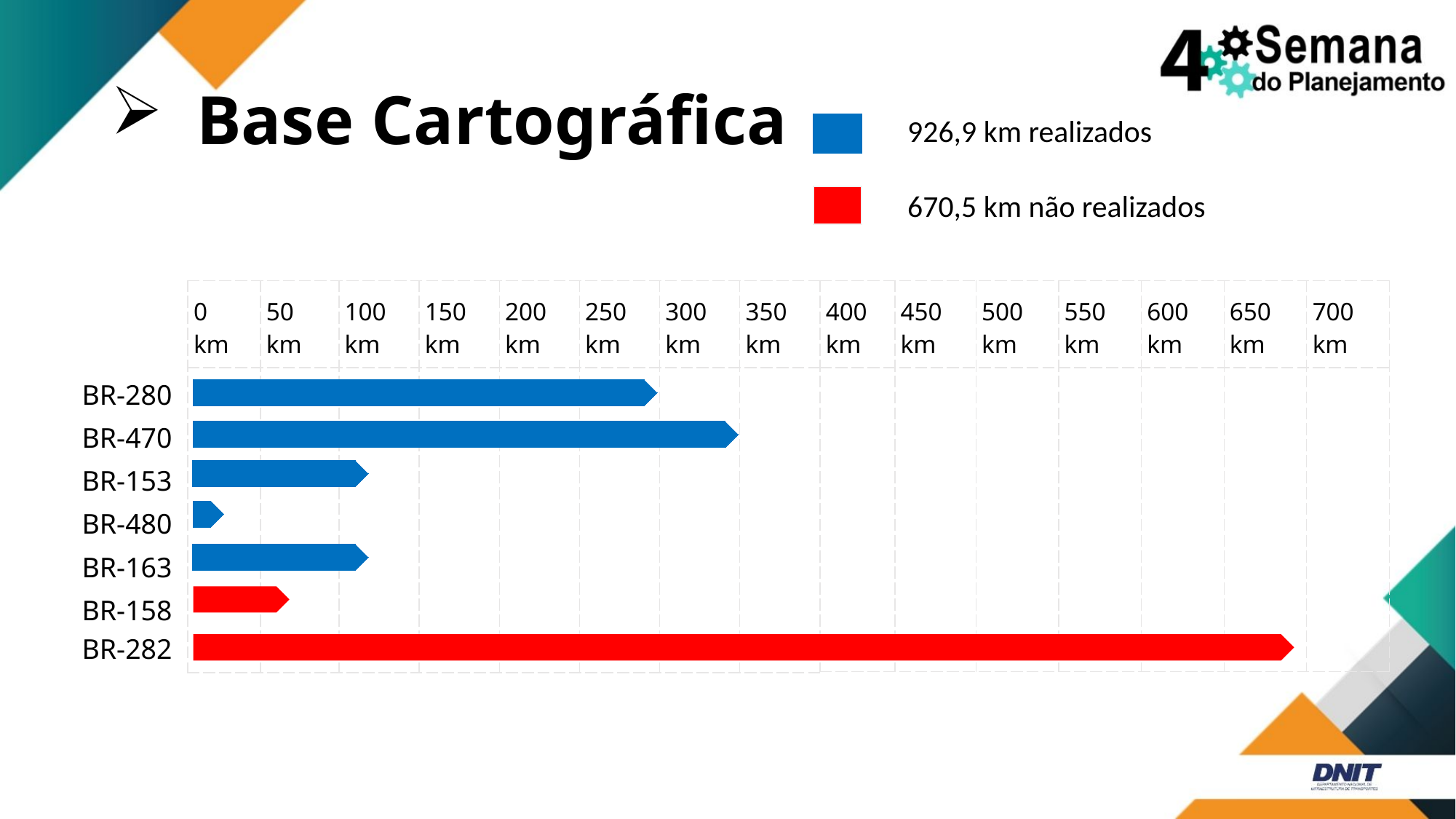
How many series does the legend list? 2 What kind of chart is shown on the slide? bar chart Which has a larger value, BR-470 or BR-280? BR-470 According to the legend, how many km are marked as 'realizados' (blue)? 926,9 km Is the value for BR-282 greater or less than 650 km? greater Is the value for BR-280 greater or less than 250 km? greater How many road categories (BR-xxx) are plotted in the chart? 7 Is the value for BR-470 greater or less than 300 km? greater Which road has the longest bar in the chart? BR-282 What colour is the bar for BR-282? red Which road has the shortest bar in the chart? BR-480